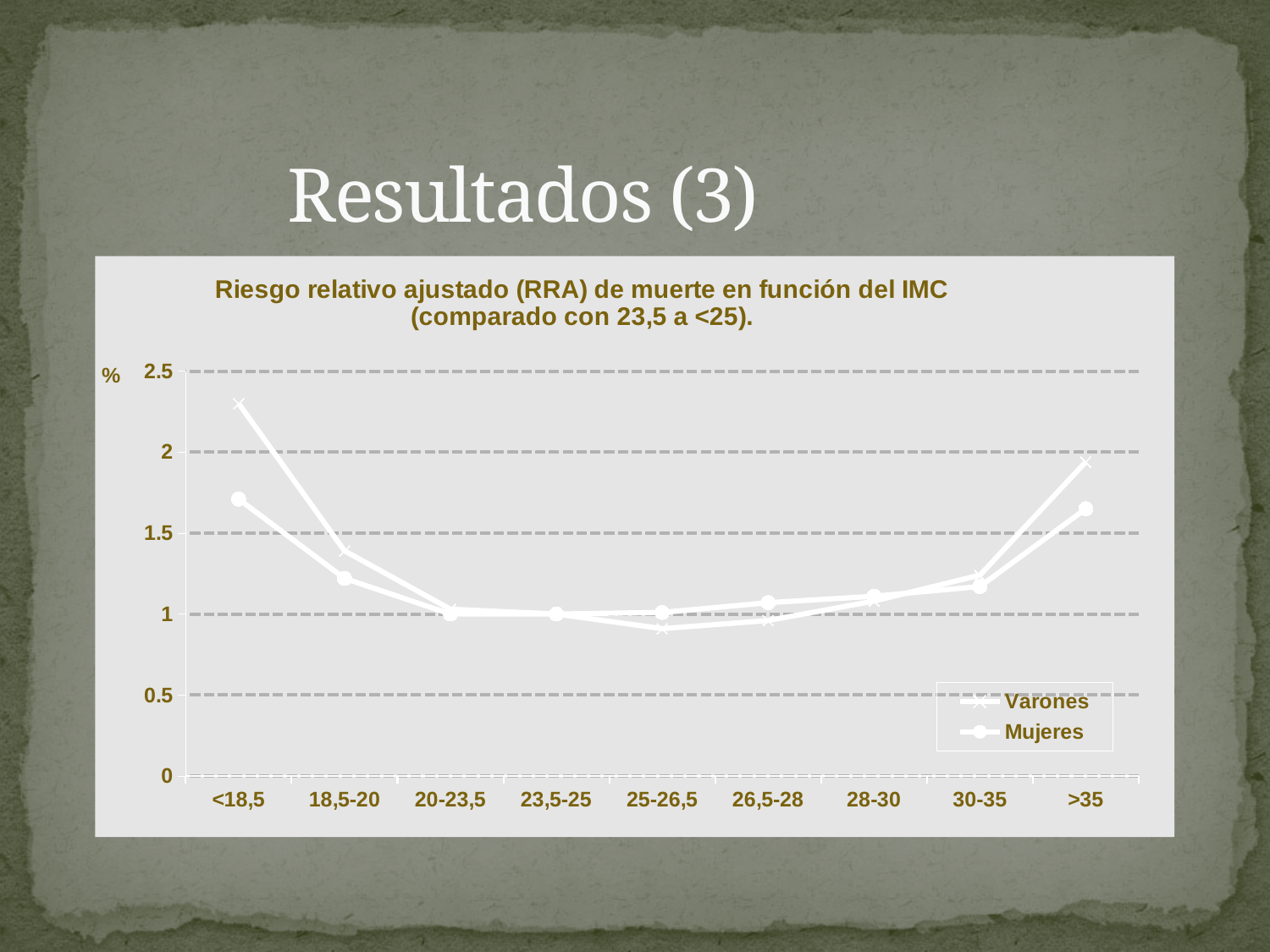
How many IMC categories are shown on the x axis? 9 Which IMC category has the highest value for Varones? <18,5 Is the value for Mujeres at >35 greater or less than 1.5? greater How many series does the legend list? 2 Is the value for Mujeres at <18,5 greater or less than 2? less What is the title of the chart? Riesgo relativo ajustado (RRA) de muerte en función del IMC (comparado con 23,5 a <25). Is the value for Varones at <18,5 greater or less than 2? greater Do the Varones values rise or fall from <18,5 to 23,5-25? fall What kind of chart is shown on the slide? line chart At <18,5, which series has the larger value, Varones or Mujeres? Varones Which IMC category has the highest value for Mujeres? <18,5